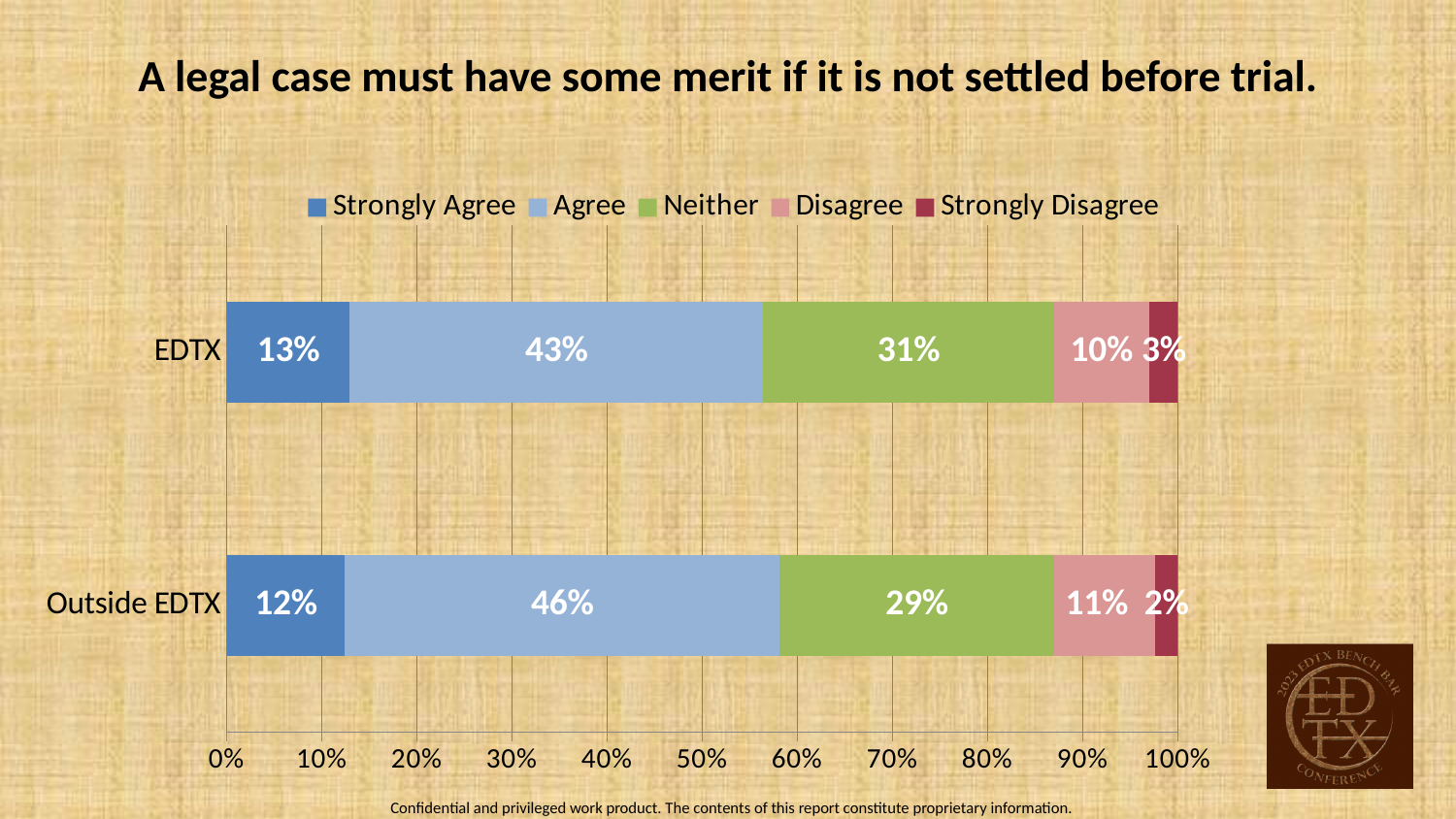
What percentage of Outside EDTX respondents chose "Neither"? 29% What kind of chart is shown on the slide? Stacked bar chart Which response option has the largest share for EDTX? Agree What is the "Disagree" value for Outside EDTX? 11% What is the title of the chart? A legal case must have some merit if it is not settled before trial. What percentage of EDTX respondents chose "Agree"? 43% Which group has a higher "Neither" value, EDTX or Outside EDTX? EDTX How many categories (groups) are shown on the chart? 2 What is the difference between the "Agree" values for Outside EDTX and EDTX? 3% How many series does the legend list? 5 What is the "Strongly Disagree" value for EDTX? 3% Which response option has the smallest share for Outside EDTX? Strongly Disagree